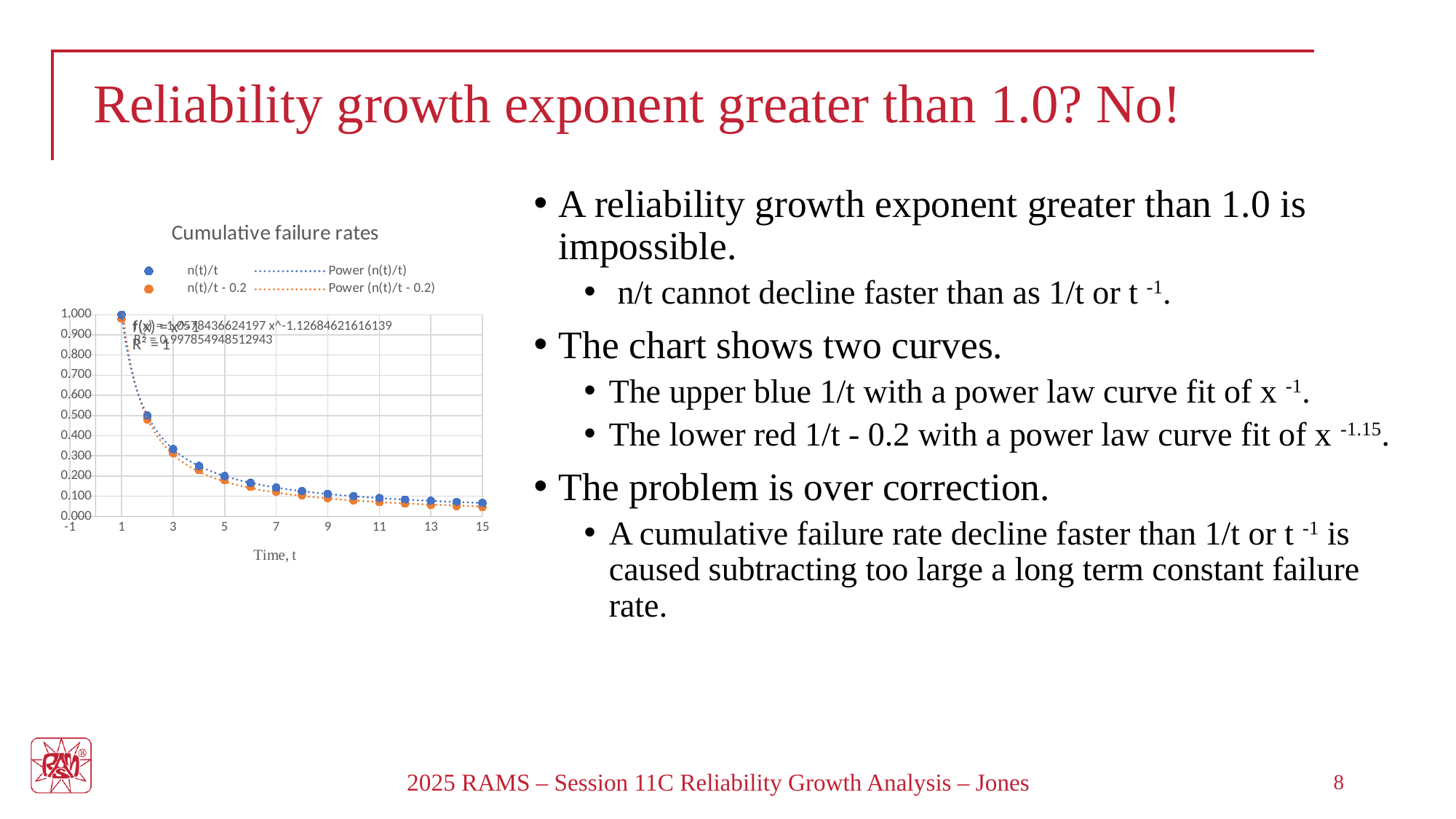
Is the value of n(t)/t at t = 3 greater or less than 0.400? less At t = 5, which series has the larger value, n(t)/t or n(t)/t - 0.2? n(t)/t What is the title of the chart? Cumulative failure rates What is the value of n(t)/t at time t = 5? 0.200 Do the n(t)/t values rise or fall as time t increases? Fall What is the x-axis title of the chart? Time, t How many data points does the n(t)/t series have? 15 How many entries does the chart legend list? 4 What kind of chart is shown on the slide? Scatter chart Is the value of n(t)/t - 0.2 at t = 15 greater or less than 0.100? less What is the value of n(t)/t at time t = 1? 1.000 At which time t is the n(t)/t series at its highest value? 1